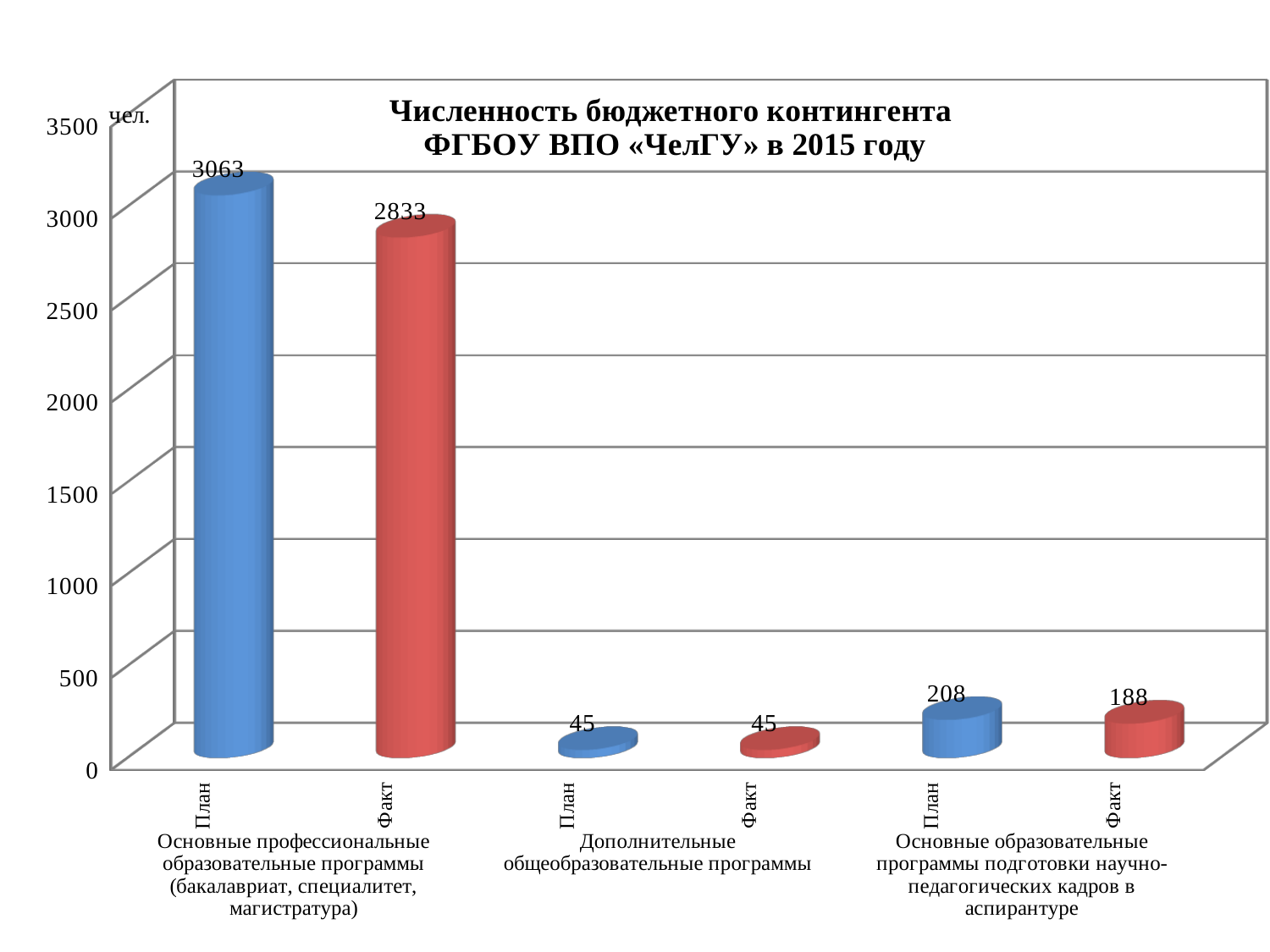
What is the planned (План) value for Основные профессиональные образовательные программы? 3063 What is the title of the chart? Численность бюджетного контингента ФГБОУ ВПО «ЧелГУ» в 2015 году What is the actual (Факт) value for Основные профессиональные образовательные программы? 2833 Is the Факт value for Основные профессиональные образовательные программы greater or less than 3000? less What is the difference between the План and Факт values for the аспирантура programmes? 20 What is the actual (Факт) value for Дополнительные общеобразовательные программы? 45 What is the planned (План) value for Основные образовательные программы подготовки научно-педагогических кадров в аспирантуре? 208 Which is larger for the аспирантура programmes: План or Факт? План What is the difference between the План and Факт values for Основные профессиональные образовательные программы? 230 What type of chart is shown on the slide? Bar chart Which bar has the highest value on the chart? План, Основные профессиональные образовательные программы (3063) How many bars are plotted on the chart? 6